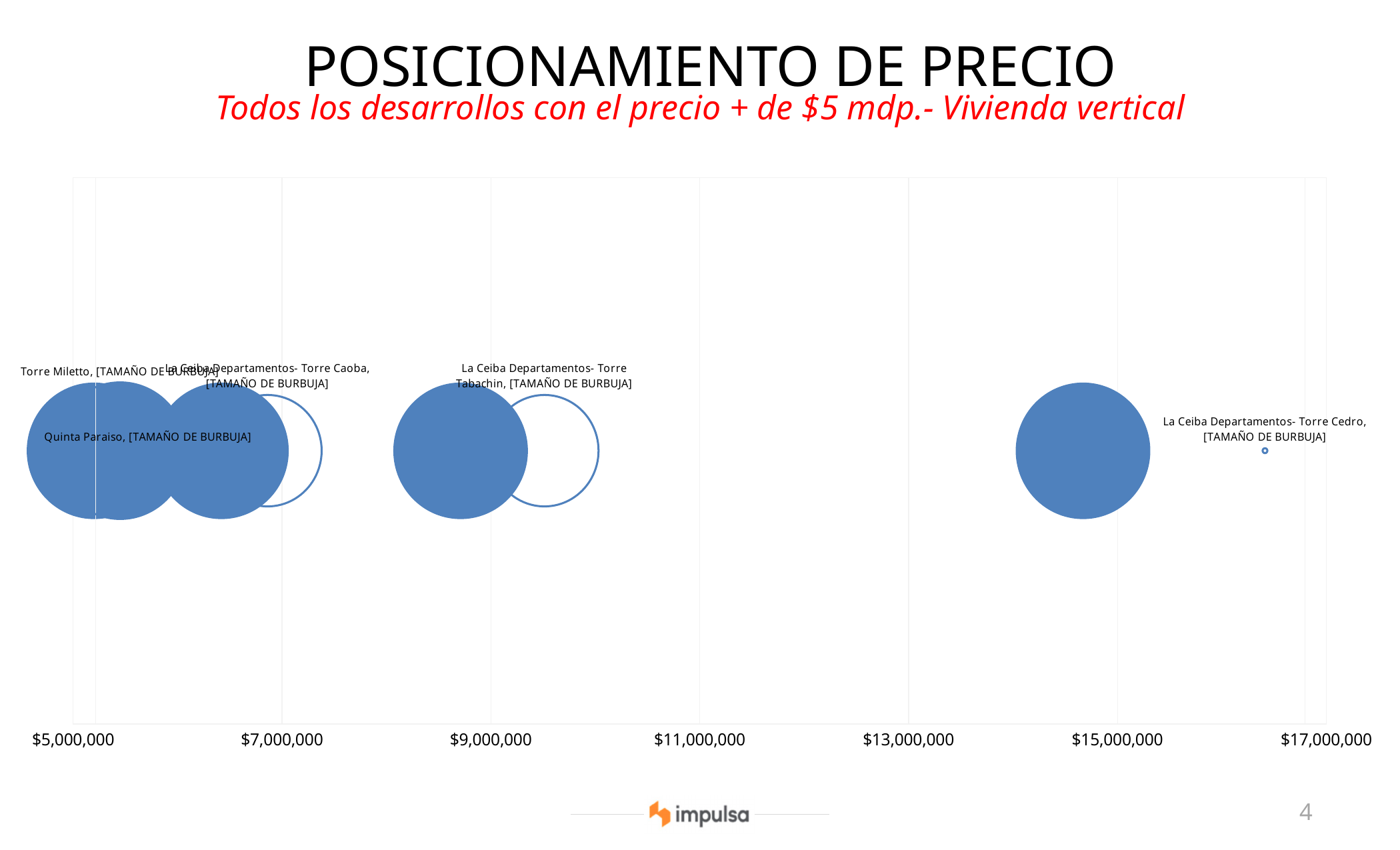
Which labelled development is positioned furthest to the right on the price axis? La Ceiba Departamentos- Torre Cedro What is the title of the slide's chart section? POSICIONAMIENTO DE PRECIO What is the lowest price value labelled on the x axis? $5,000,000 How many developments are labelled on the chart? 5 What kind of chart is shown on the slide? Bubble chart Which labelled development is positioned furthest to the left on the price axis? Torre Miletto What is the highest price value labelled on the x axis? $17,000,000 Which is positioned at a higher price, Torre Miletto or La Ceiba Departamentos- Torre Cedro? La Ceiba Departamentos- Torre Cedro Is the value for Torre Miletto greater or less than $7,000,000? less Is the value for Quinta Paraiso greater or less than $7,000,000? less